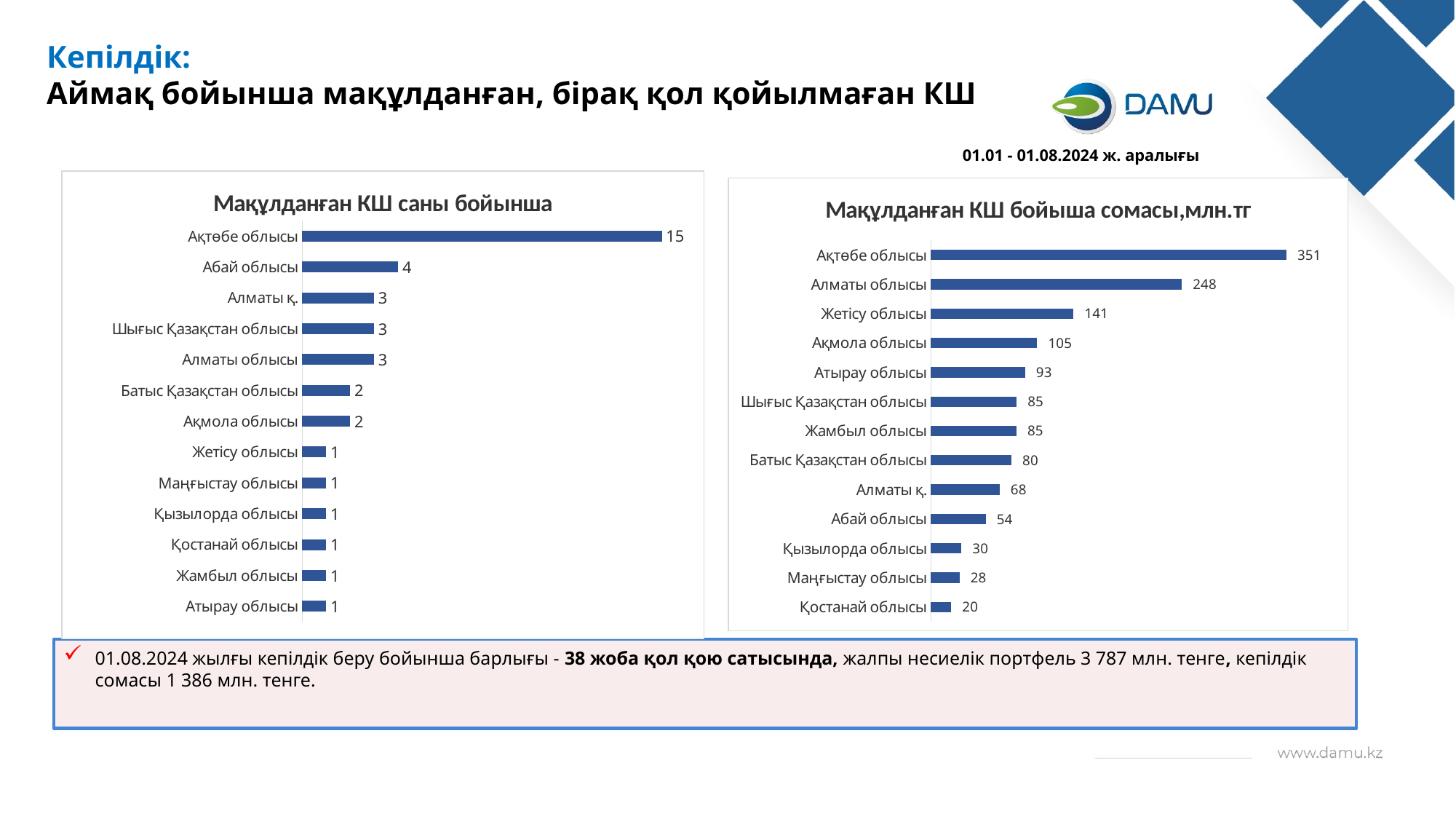
In the chart titled "Мақұлданған КШ саны бойынша", what is the difference between Ақтөбе облысы and Абай облысы? 11 In the chart titled "Мақұлданған КШ бойыша сомасы,млн.тг", what is the value for Жетісу облысы? 141 In the chart titled "Мақұлданған КШ бойыша сомасы,млн.тг", what is the value for Маңғыстау облысы? 28 What kind of chart is the chart titled "Мақұлданған КШ бойыша сомасы,млн.тг"? Bar chart In the chart titled "Мақұлданған КШ бойыша сомасы,млн.тг", what is the difference between Ақтөбе облысы and Алматы облысы? 103 In the chart titled "Мақұлданған КШ саны бойынша", what is the value for Абай облысы? 4 In the chart titled "Мақұлданған КШ бойыша сомасы,млн.тг", which is larger: Атырау облысы or Абай облысы? Атырау облысы In the chart titled "Мақұлданған КШ саны бойынша", what is the value for Батыс Қазақстан облысы? 2 In the chart titled "Мақұлданған КШ саны бойынша", which category has the highest value? Ақтөбе облысы In the chart titled "Мақұлданған КШ бойыша сомасы,млн.тг", which category has the lowest value? Қостанай облысы In the chart titled "Мақұлданған КШ саны бойынша", how many categories are shown? 13 What is the title of the chart on the left side of the slide? Мақұлданған КШ саны бойынша